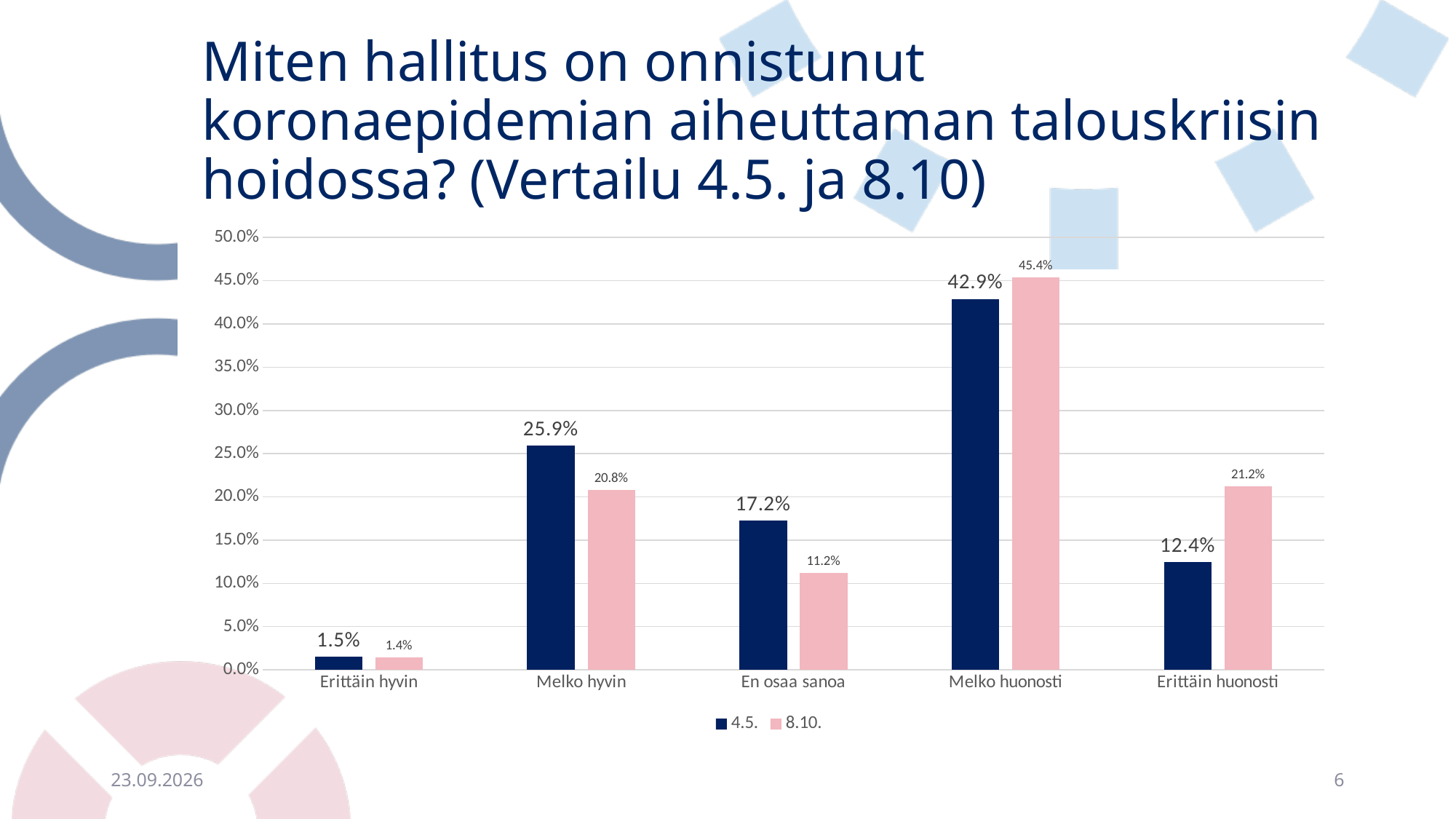
Is the 4.5. value for "Melko huonosti" greater or less than 40.0%? greater What is the value for "Melko hyvin" in the 4.5. series? 25.9% What is the value for "En osaa sanoa" in the 8.10. series? 11.2% How many categories are shown on the x axis? 5 What is the difference between the 4.5. and 8.10. values for "Melko hyvin"? 5.1% For "Melko huonosti", which series has the larger value, 4.5. or 8.10.? 8.10. How many series does the legend list? 2 What is the value for "Erittäin huonosti" in the 8.10. series? 21.2% What is the difference between the 8.10. and 4.5. values for "Erittäin huonosti"? 8.8% What kind of chart is shown on the slide? bar chart Which category has the highest value in the 8.10. series? Melko huonosti Which category has the lowest value in the 4.5. series? Erittäin hyvin